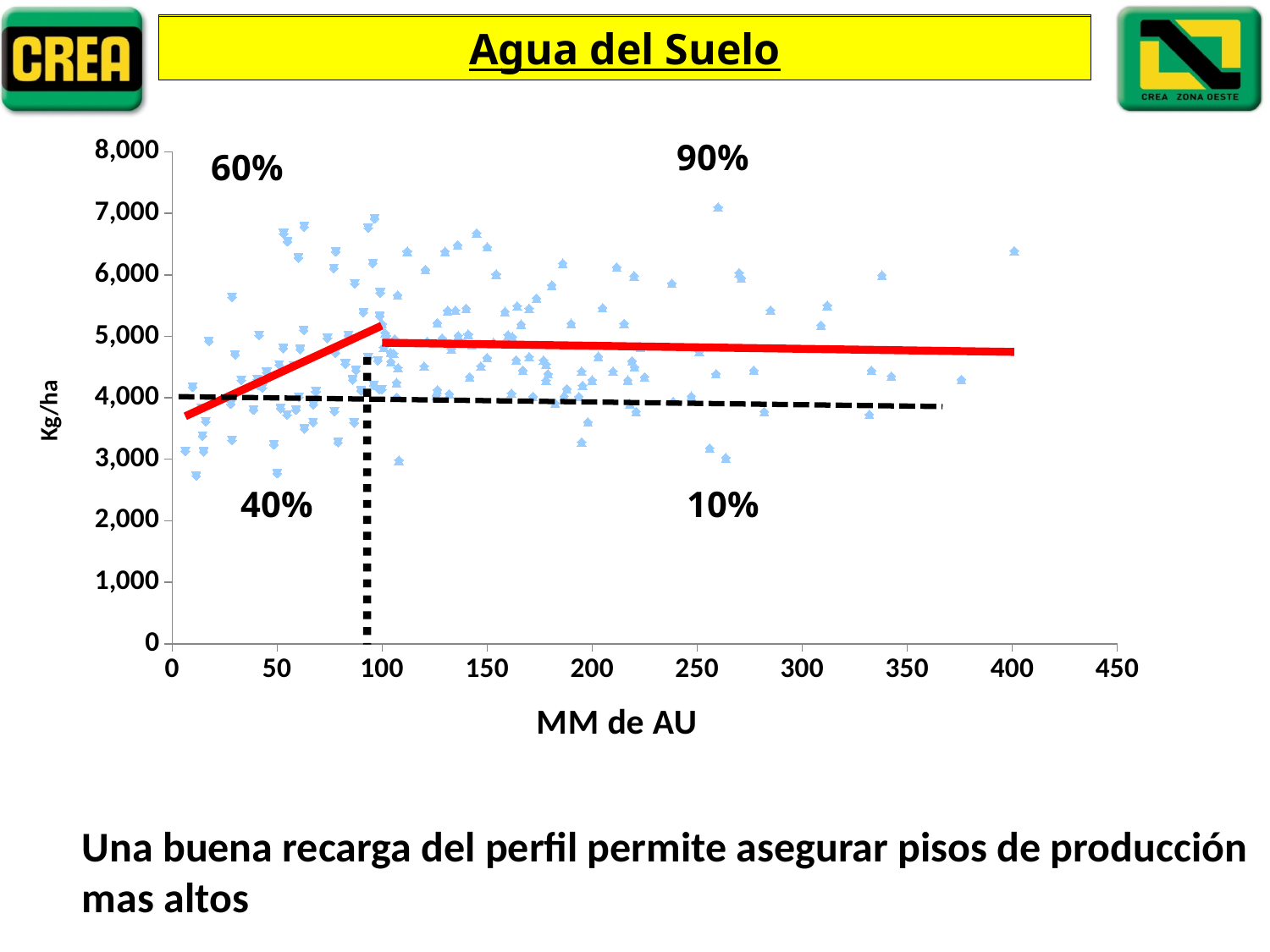
What percentage label is printed in the lower-left region of the chart? 40% What kind of chart is shown on the slide? scatter chart What is the title of the y axis of the chart? Kg/ha What is the title of the x axis of the chart? MM de AU What is the highest value shown on the x axis of the chart? 450 Does the red line rise or fall as MM de AU increases from 0 to 100? rise Is the lowest plotted point on the chart greater or less than 3,000 Kg/ha? less What is the highest value shown on the y axis of the chart? 8,000 What percentage label is printed in the upper-right region of the chart? 90% At 200 MM de AU, which is higher on the chart: the red line or the black dashed line? the red line What percentage label is printed in the lower-right region of the chart? 10% What percentage label is printed in the upper-left region of the chart? 60%